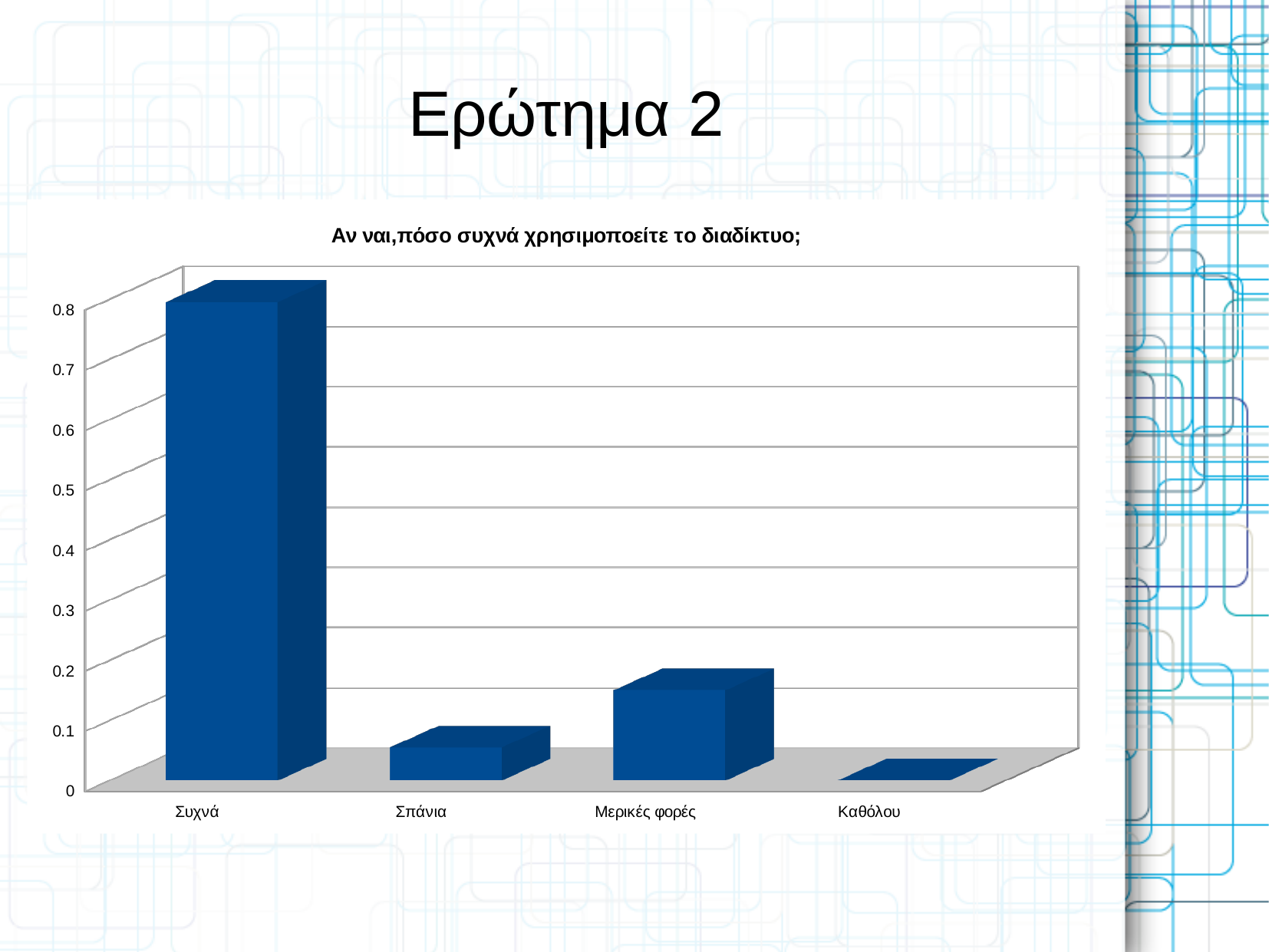
What kind of chart is shown on the slide? bar chart Which category has the highest value in the chart? Συχνά Which is larger, the value for Σπάνια or the value for Μερικές φορές? Μερικές φορές Is the value for Μερικές φορές greater or less than 0.1? greater Is the value for Σπάνια greater or less than 0.1? less How many categories are shown on the x axis of the chart? 4 Is the value for Καθόλου greater or less than 0.1? less What is the title of the chart? Αν ναι,πόσο συχνά χρησιμοποείτε το διαδίκτυο; Which is larger, the value for Συχνά or the value for Μερικές φορές? Συχνά Which category has the lowest value in the chart? Καθόλου